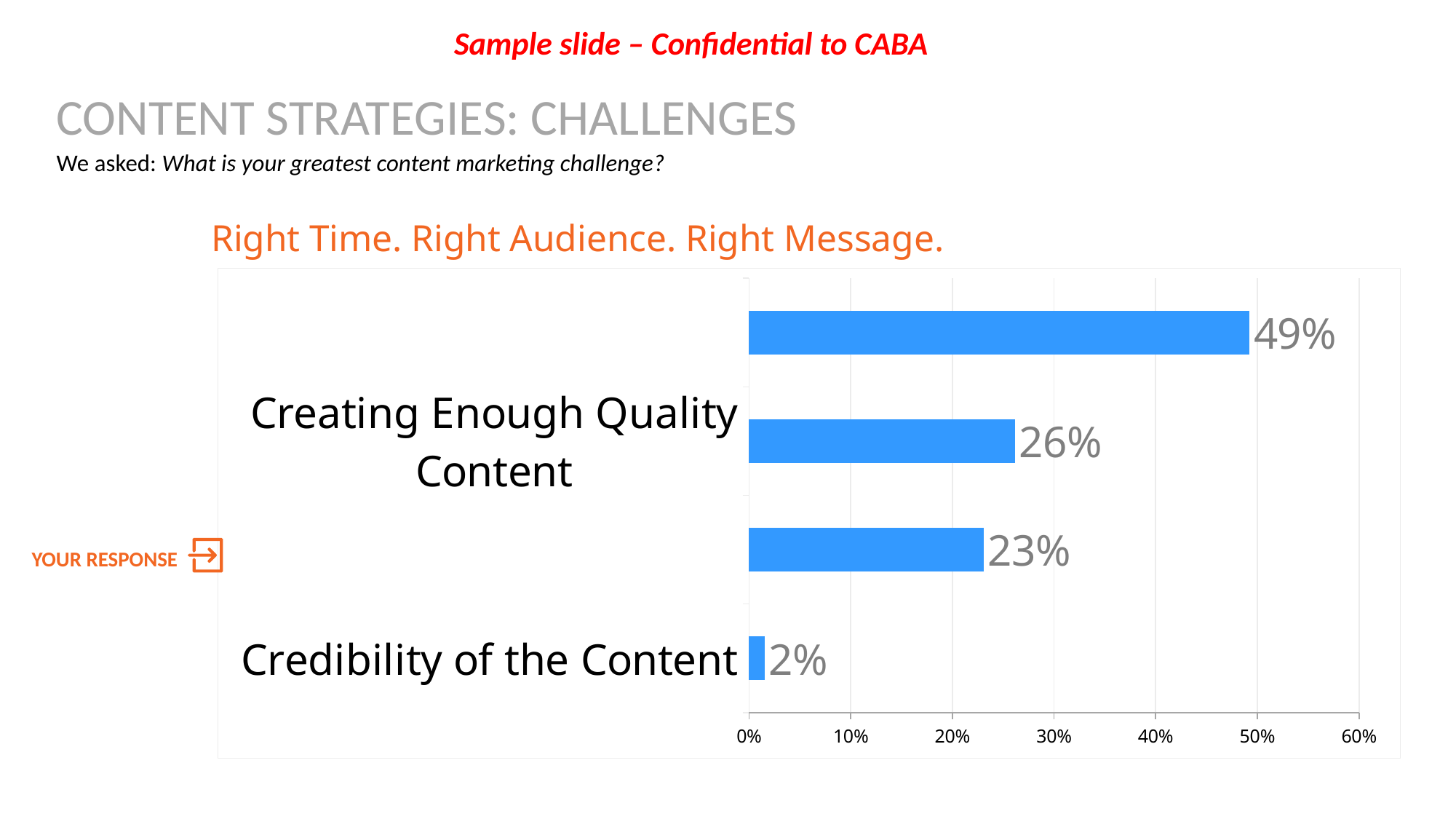
What is the value for Credibility of the Content? 2% What is the difference between the values for Creating Enough Quality Content and Credibility of the Content? 24% Which labelled category has the lowest value? Credibility of the Content What is the value for Creating Enough Quality Content? 26% What is the title shown above the chart? Right Time. Right Audience. Right Message. What is the difference between the largest value on the chart and the value for Creating Enough Quality Content? 23% What kind of chart is shown on the slide? bar chart Is the value for Credibility of the Content greater or less than 10%? less How many bars are plotted on the chart? 4 What is the largest value shown on the chart? 49% Which is larger, Creating Enough Quality Content or Credibility of the Content? Creating Enough Quality Content Is the value for Creating Enough Quality Content greater or less than 20%? greater